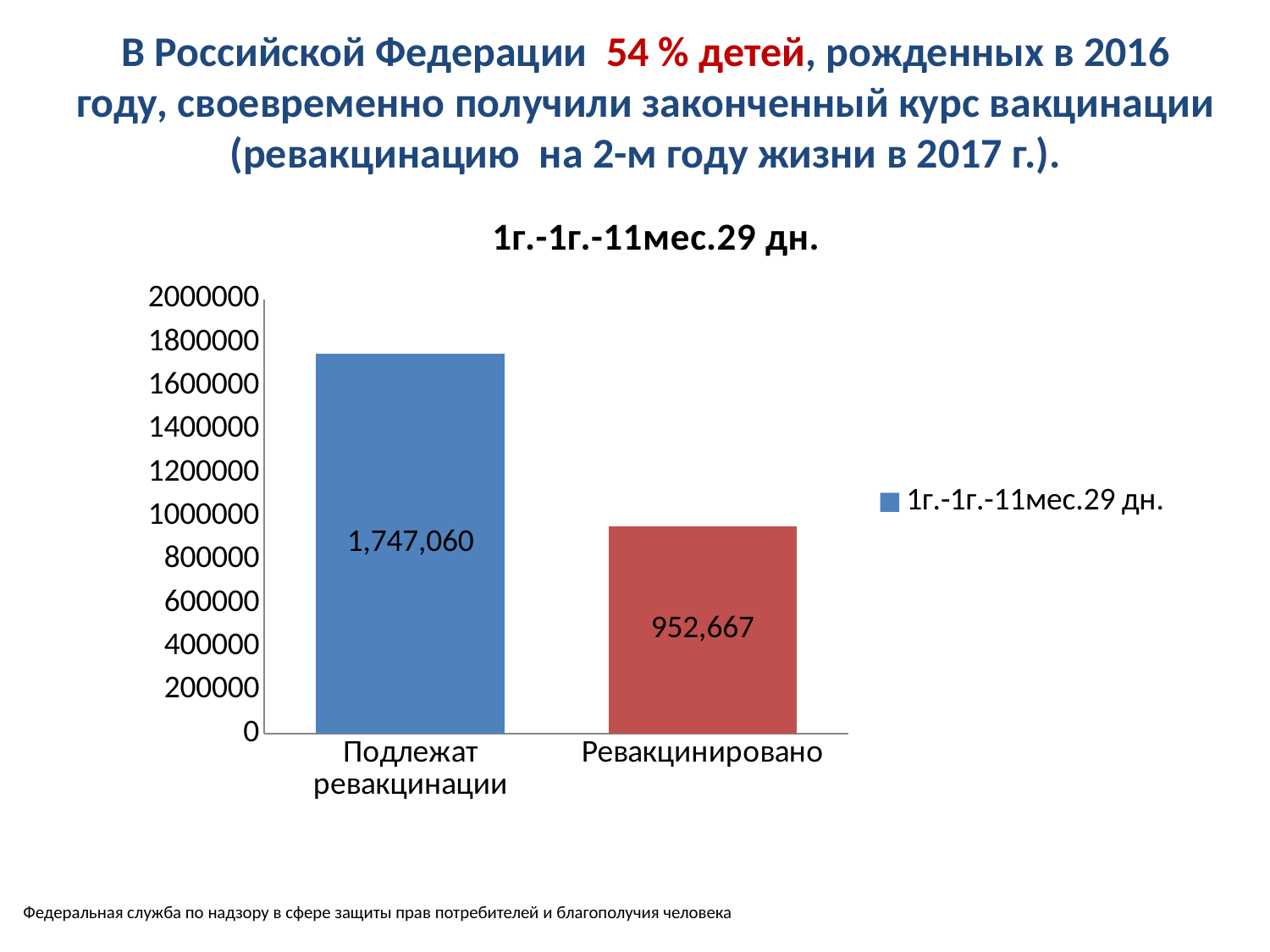
What kind of chart is shown on the slide? bar chart Which category has the lowest value? Ревакцинировано Is the value for Подлежат ревакцинации greater or less than 1600000? greater Which category has the highest value? Подлежат ревакцинации What is the difference between the values for Подлежат ревакцинации and Ревакцинировано? 794,393 Is the value for Ревакцинировано greater or less than 1000000? less What is the value for Подлежат ревакцинации? 1,747,060 What is the title of the chart? 1г.-1г.-11мес.29 дн. How many series does the legend list? 1 How many categories are shown on the x axis? 2 What is the value for Ревакцинировано? 952,667 Which is larger, the value for Подлежат ревакцинации or the value for Ревакцинировано? Подлежат ревакцинации